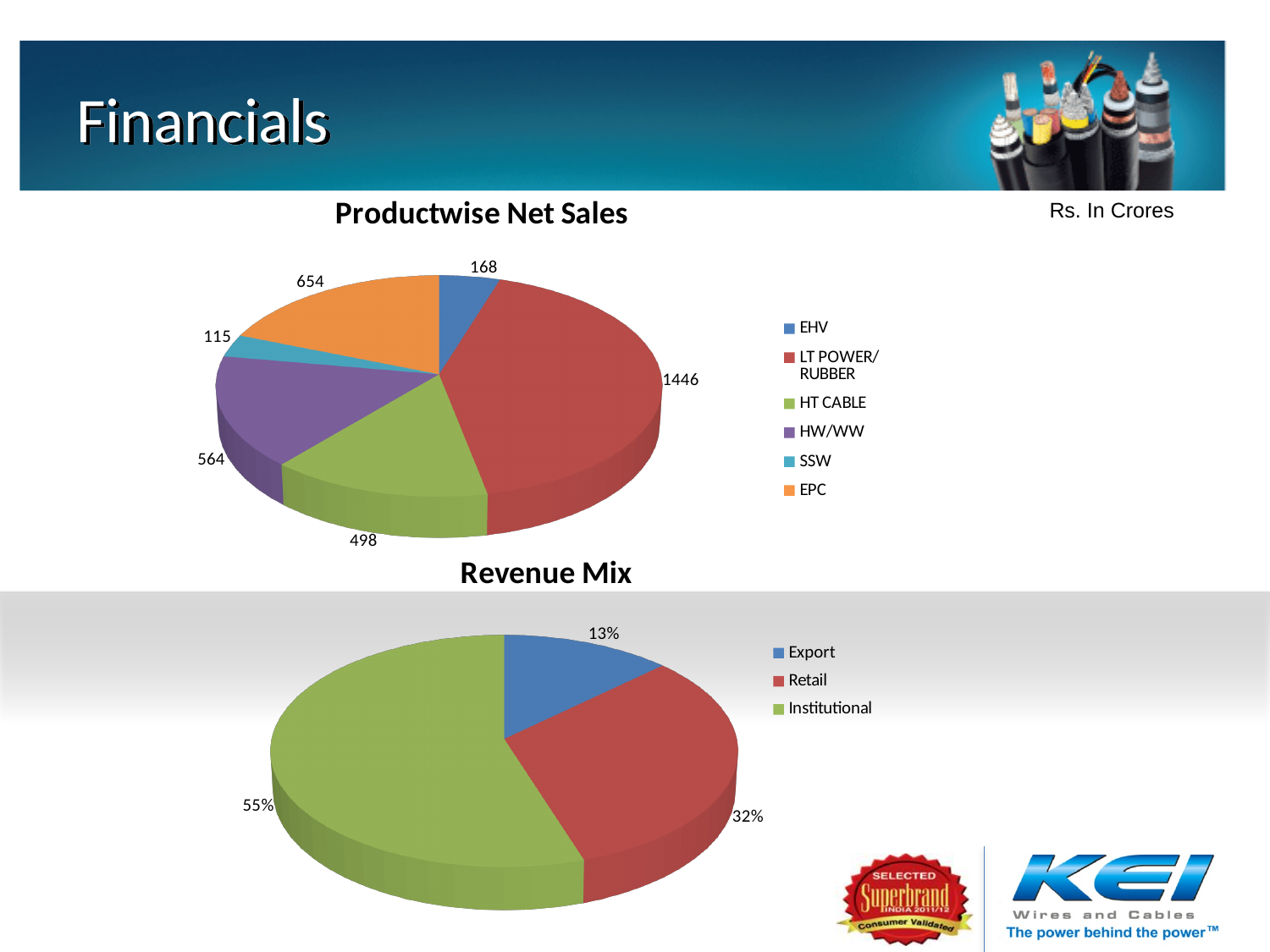
In the Revenue Mix chart, what is the difference between the Retail and Export shares? 19% How many categories does the Productwise Net Sales chart show? 6 In the Productwise Net Sales chart, which product has the highest net sales? LT POWER/RUBBER In the Productwise Net Sales chart, which is larger, EPC or HW/WW? EPC In the Productwise Net Sales chart, what is the value for SSW? 115 In the Productwise Net Sales chart, what is the difference between HW/WW and HT CABLE? 66 In the Revenue Mix chart, what share of revenue comes from Institutional? 55% In the Productwise Net Sales chart, which product has the lowest net sales? SSW In the Productwise Net Sales chart, what is the value for LT POWER/RUBBER? 1446 In the Productwise Net Sales chart, what is the value for EPC? 654 What type of chart is the Revenue Mix chart? Pie chart What unit is stated for the Productwise Net Sales chart? Rs. In Crores